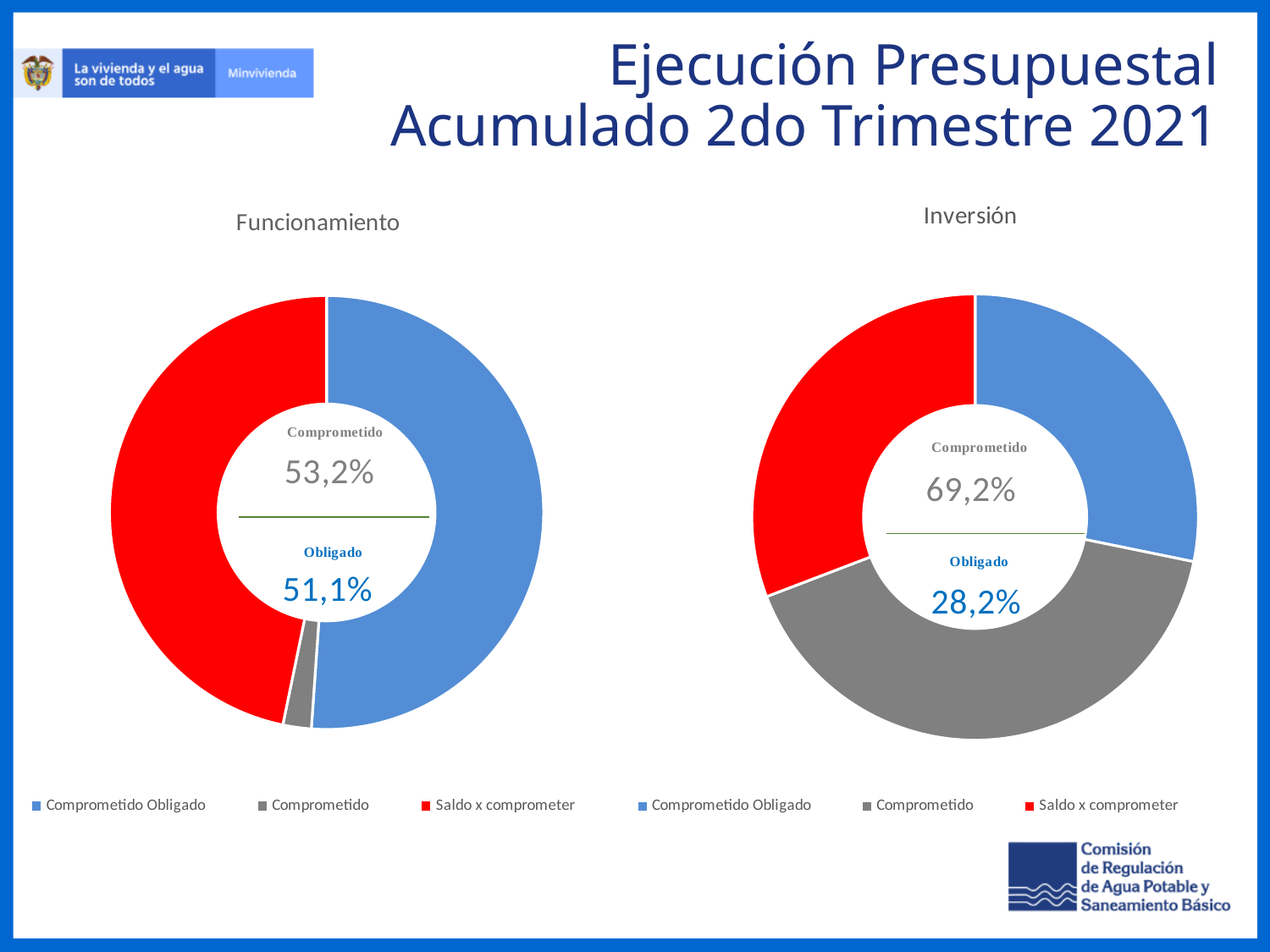
In the Inversión chart, what Obligado percentage is shown in the centre? 28,2% How many entries does the legend of the Funcionamiento chart list? 3 Which chart shows the higher Comprometido percentage, Funcionamiento or Inversión? Inversión In the Inversión chart, what is the difference between the Comprometido and Obligado percentages shown in the centre? 41,0% In the Funcionamiento chart, what Obligado percentage is shown in the centre? 51,1% What is the difference between the Comprometido percentage of the Inversión chart and that of the Funcionamiento chart? 16,0% Which chart shows the higher Obligado percentage, Funcionamiento or Inversión? Funcionamiento In the Inversión chart, what Comprometido percentage is shown in the centre? 69,2% In the Funcionamiento chart, which legend category has the smallest slice? Comprometido In the Funcionamiento chart, what Comprometido percentage is shown in the centre? 53,2% In the Inversión chart, which legend category has the largest slice? Comprometido What type of chart is used for the Funcionamiento and Inversión charts? Doughnut (pie) chart